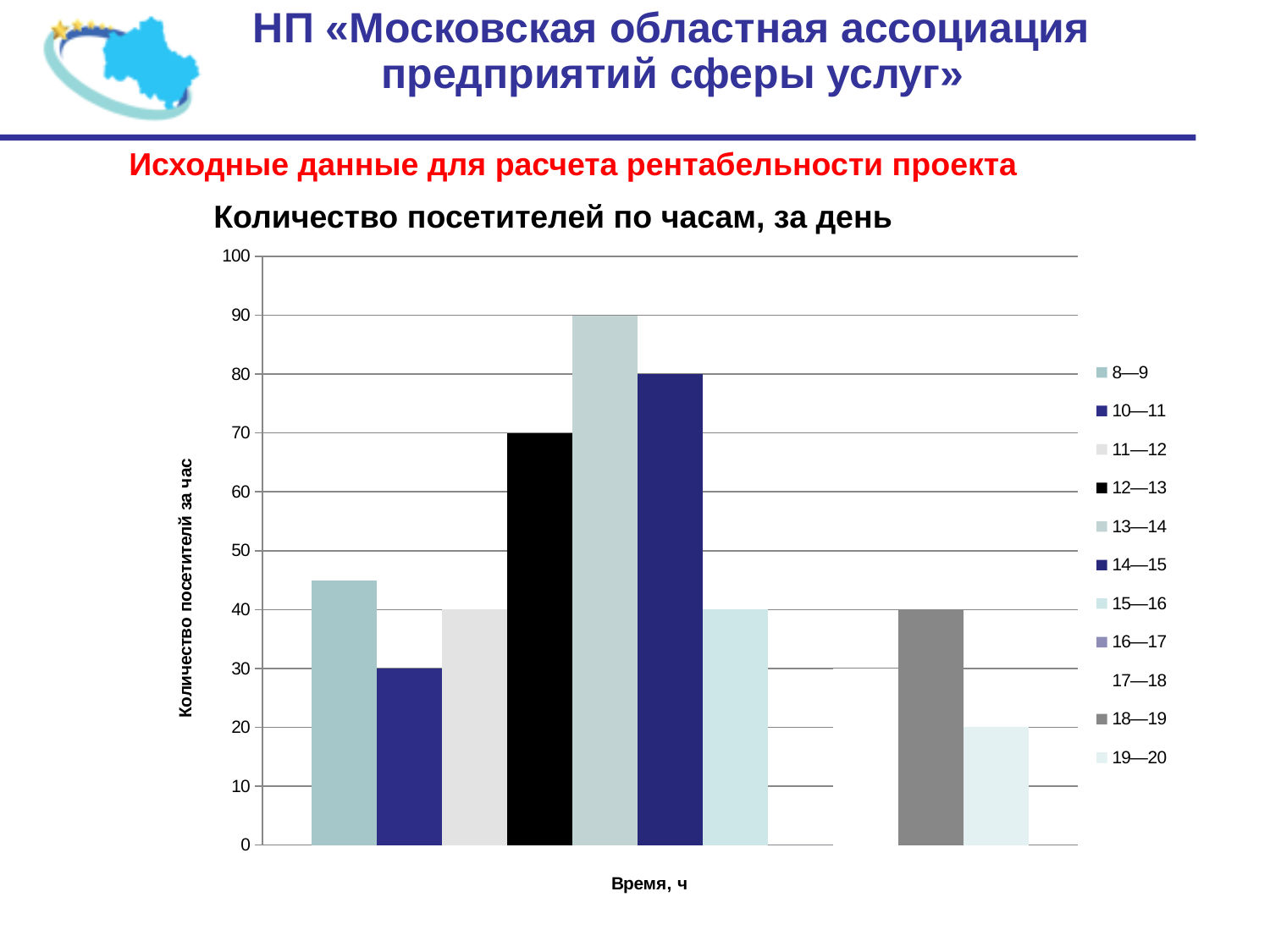
What is the value for the 10—11 series? 30 What is the value for the 12—13 series? 70 Which series has the highest value? 13—14 What is the label of the vertical axis? Количество посетителей за час What is the value for the 19—20 series? 20 How many entries does the chart legend list? 11 What is the value for the 13—14 series? 90 What is the title of the chart? Количество посетителей по часам, за день Is the value for 8—9 greater or less than 40? greater What type of chart is shown on the slide? Bar chart Which is larger, the value for 12—13 or the value for 14—15? 14—15 What is the difference between the values for 13—14 and 14—15? 10